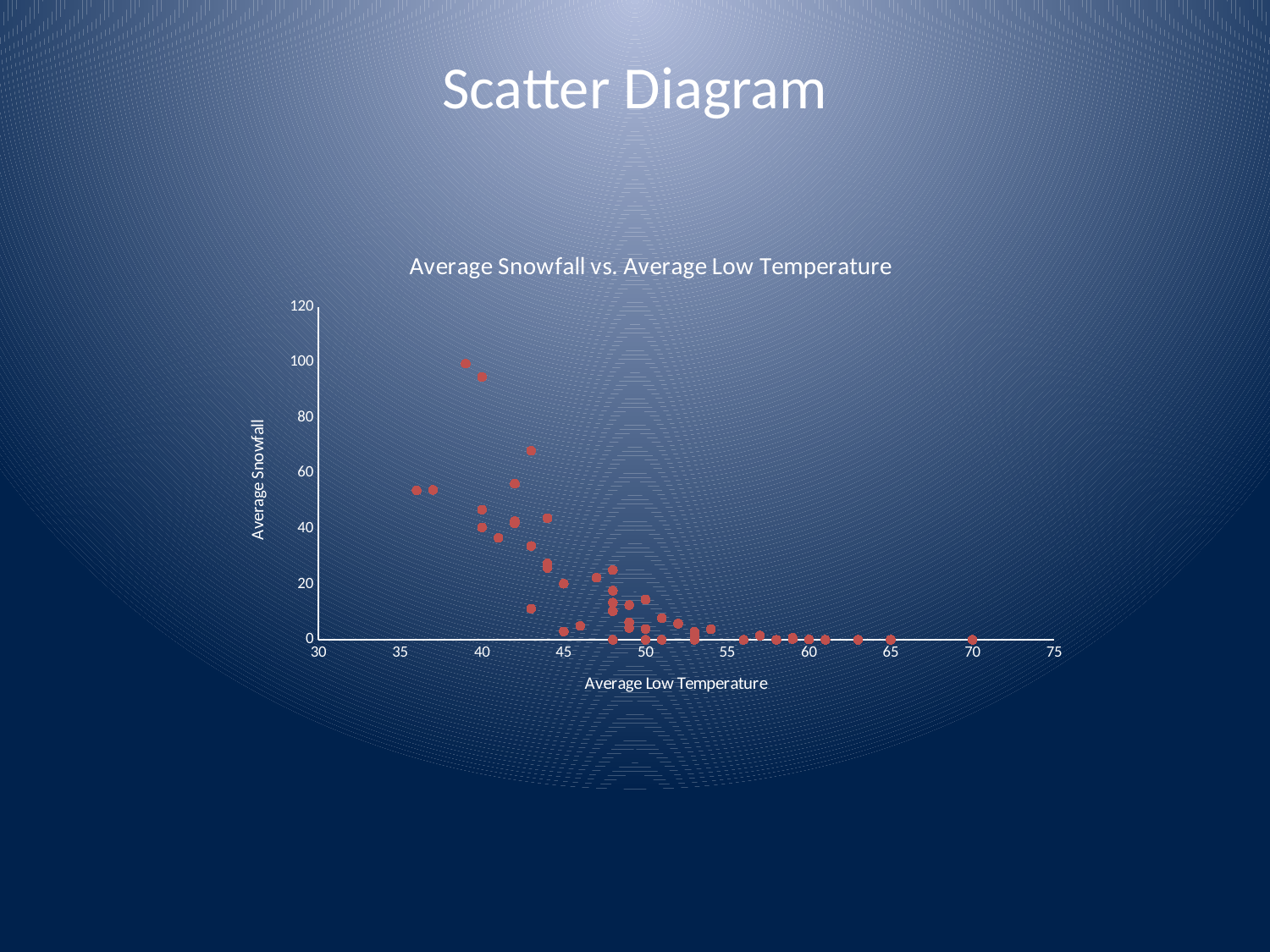
Is the average snowfall for the point at an average low temperature of 70 greater or less than 20? less What kind of chart is shown on the slide? Scatter chart Are the average snowfall values for points with average low temperature of 60 or more greater or less than 20? less Is the average snowfall for the points at an average low temperature of about 36 greater or less than 40? greater What is the title of the chart? Average Snowfall vs. Average Low Temperature As average low temperature increases along the x axis, does average snowfall generally rise or fall? Fall Which has the higher average snowfall: the point at an average low temperature of 39 or the point at 70? The point at 39 What is the label on the horizontal axis of the chart? Average Low Temperature